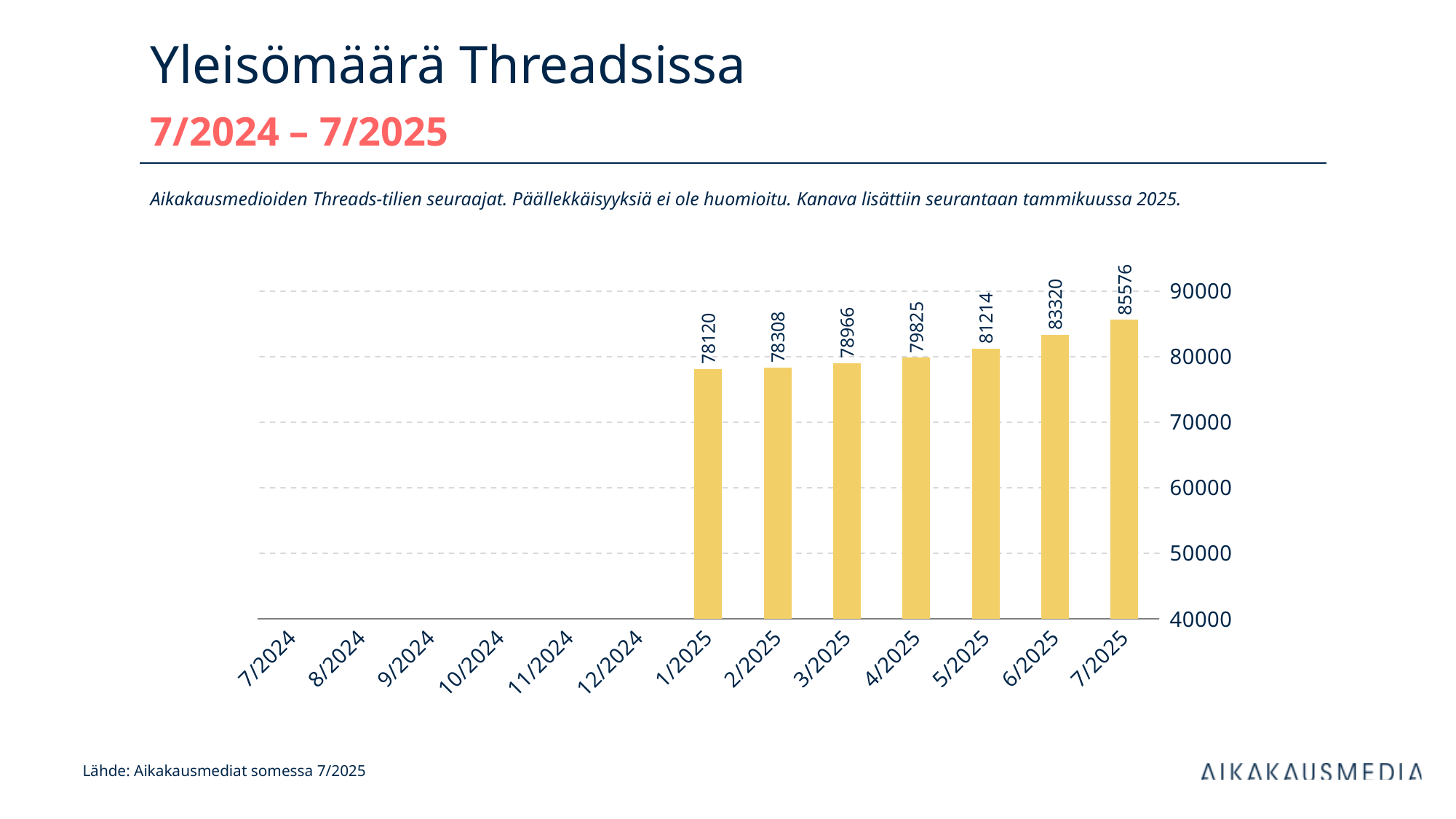
How many months are shown on the x axis? 13 What is the value for 4/2025? 79825 What is the value for 7/2025? 85576 Do the values rise or fall from 1/2025 to 7/2025? rise Is the value for 6/2025 greater or less than 80000? greater Among the months with bars, which has the lowest value? 1/2025 Which month has the highest value? 7/2025 Which is larger, the value for 5/2025 or the value for 3/2025? 5/2025 What is the difference between the values for 7/2025 and 6/2025? 2256 How many months have a bar plotted? 7 What kind of chart is shown? bar chart What is the value for 1/2025? 78120